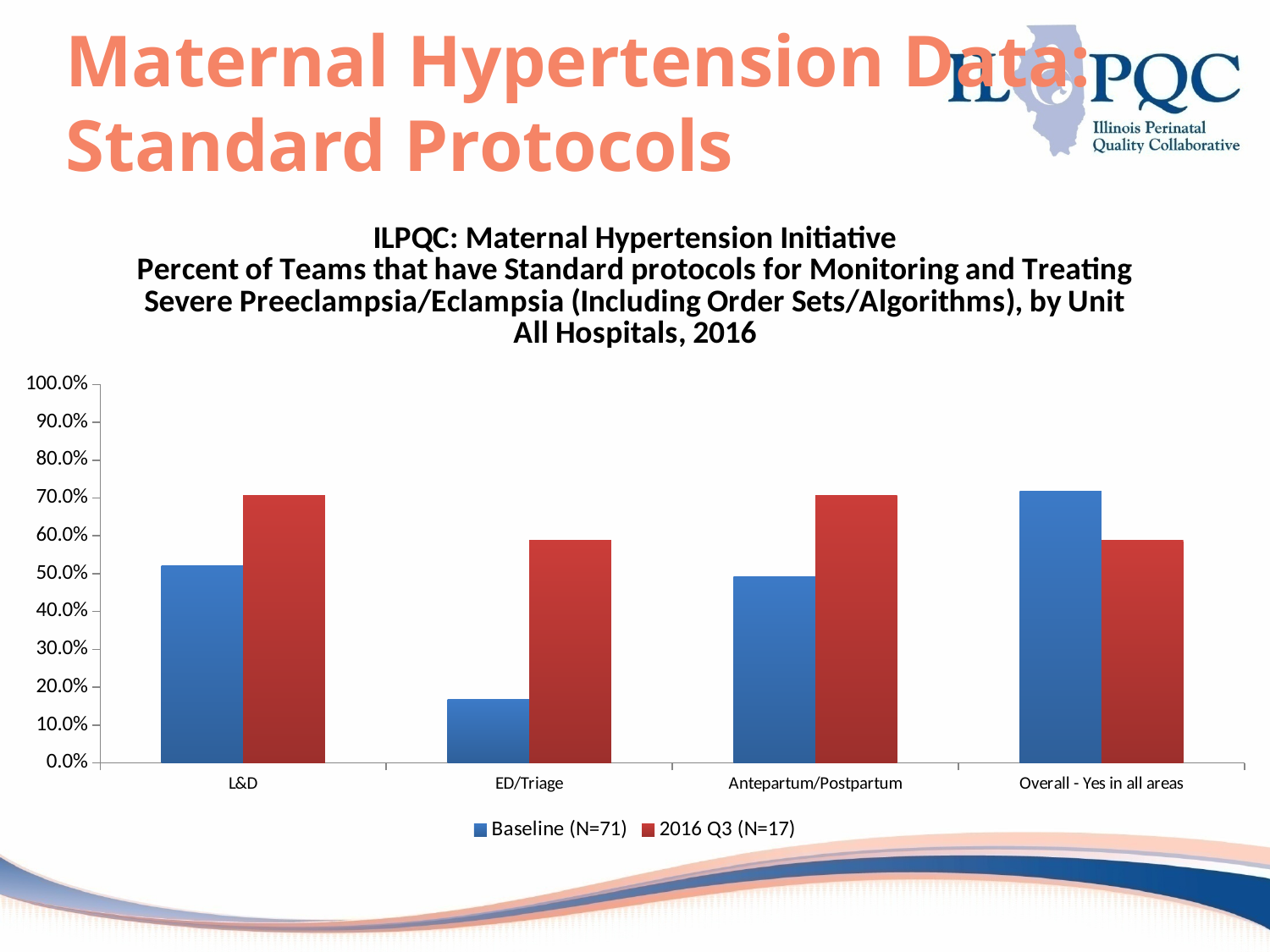
For ED/Triage, which is larger: the Baseline (N=71) value or the 2016 Q3 (N=17) value? 2016 Q3 (N=17) Which category has the highest Baseline (N=71) value? Overall - Yes in all areas Is the Baseline (N=71) value for Overall - Yes in all areas greater or less than 60.0%? greater How many unit categories are shown on the x axis? 4 Is the 2016 Q3 (N=17) value for ED/Triage greater or less than 50.0%? greater Which series is shown in red in the legend? 2016 Q3 (N=17) For L&D, which is larger: the Baseline (N=71) value or the 2016 Q3 (N=17) value? 2016 Q3 (N=17) For Overall - Yes in all areas, which is larger: the Baseline (N=71) value or the 2016 Q3 (N=17) value? Baseline (N=71) How many series does the legend list? 2 Which category has the lowest Baseline (N=71) value? ED/Triage Is the Baseline (N=71) value for ED/Triage greater or less than 20.0%? less What kind of chart is shown on the slide? bar chart